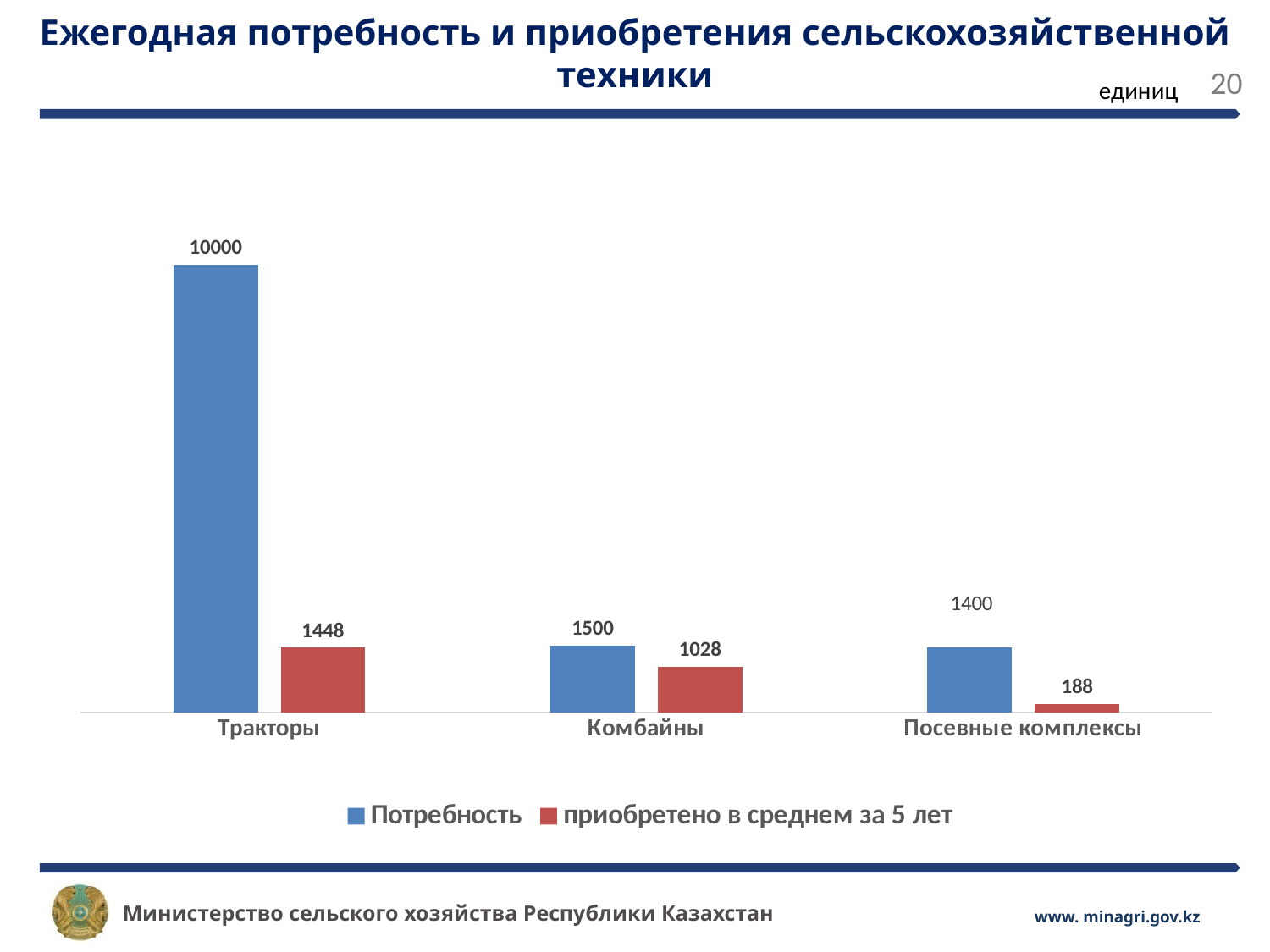
Which is larger: приобретено в среднем за 5 лет for Тракторы or for Комбайны? Тракторы What is the value of приобретено в среднем за 5 лет for Комбайны? 1028 What kind of chart is shown on the slide? Bar chart What is the value of Потребность for Тракторы? 10000 What is the value of приобретено в среднем за 5 лет for Посевные комплексы? 188 What is the value of Потребность for Посевные комплексы? 1400 How many categories are shown on the x axis? 3 What is the difference between Потребность and приобретено в среднем за 5 лет for Комбайны? 472 Which category has the highest Потребность value? Тракторы How many series does the legend list? 2 Which category has the lowest приобретено в среднем за 5 лет value? Посевные комплексы What is the difference between Потребность and приобретено в среднем за 5 лет for Тракторы? 8552